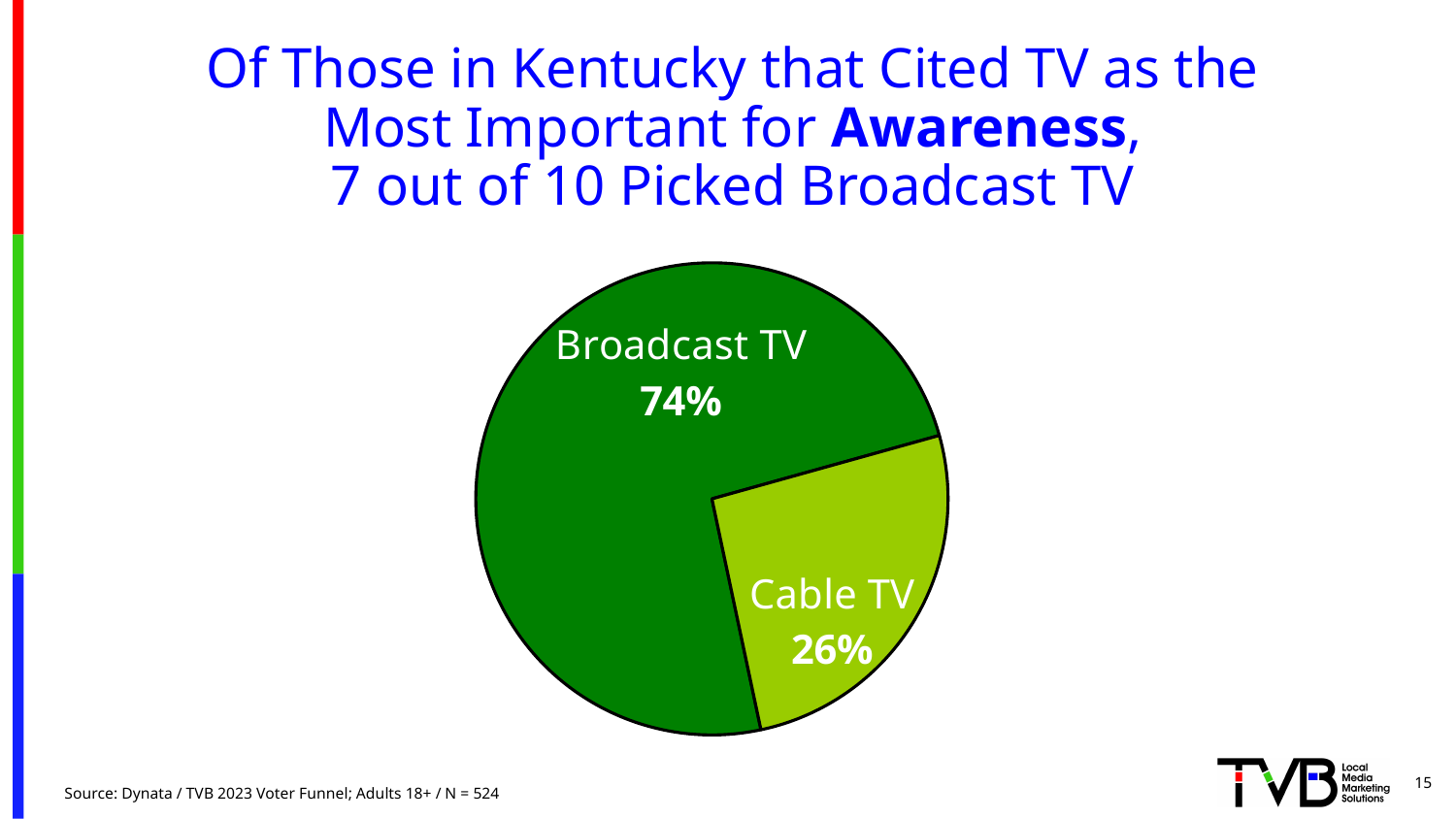
Which slice of the pie is the largest? Broadcast TV What share of the pie does Cable TV represent? 26% How many slices does the pie chart have? 2 What kind of chart is shown on the slide? Pie chart What is the total of the two slices shown in the pie chart? 100% What is the difference in percentage points between Broadcast TV and Cable TV? 48 Which is larger, the Broadcast TV slice or the Cable TV slice? Broadcast TV What colour is the Cable TV slice? Light green What percentage of the pie is Broadcast TV? 74% According to the source note, what is the sample size N? 524 Which slice of the pie is the smallest? Cable TV What percentage of the pie is Cable TV? 26%